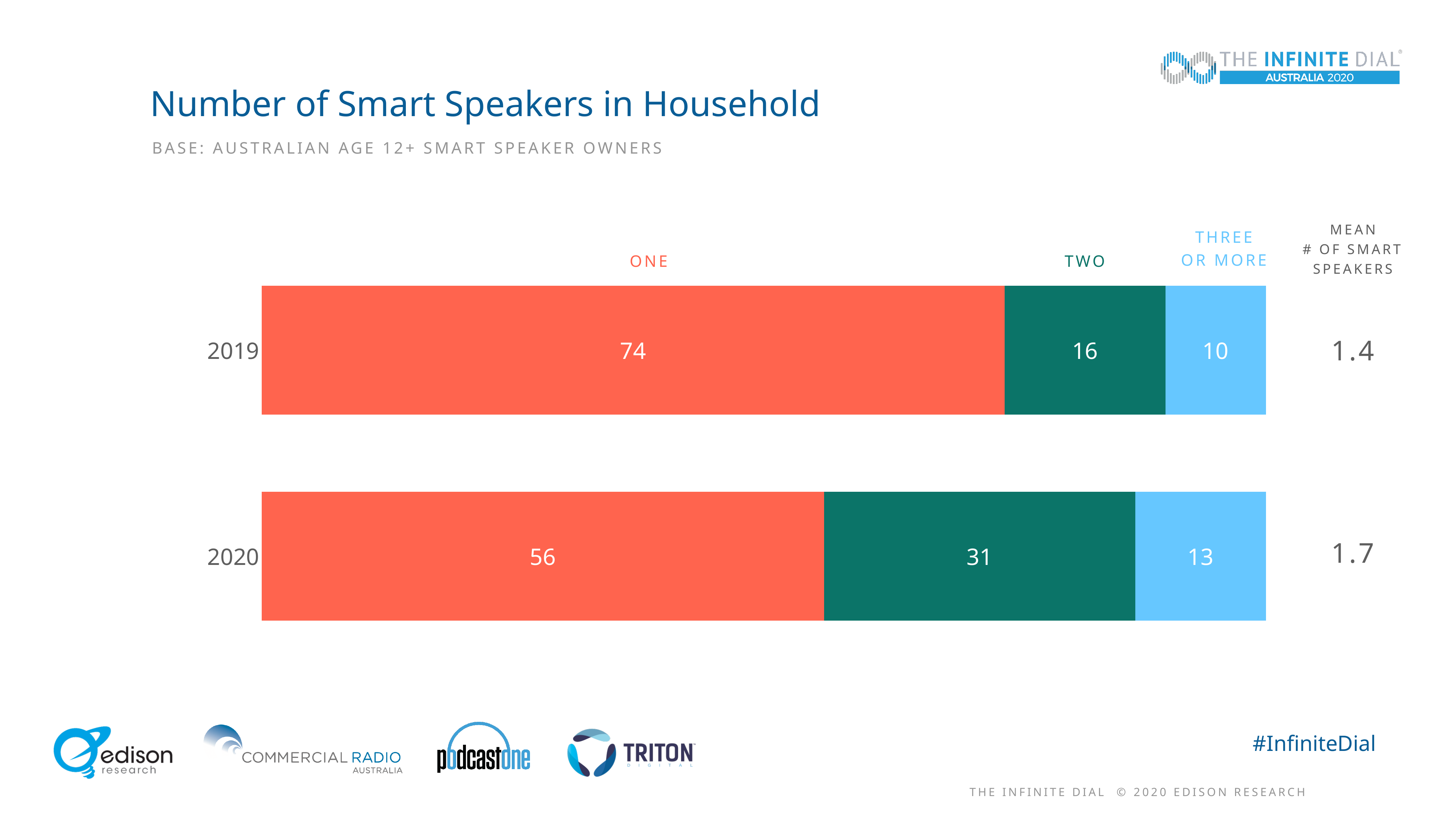
Which is larger: the "Two" value in 2019 or the "Two" value in 2020? 2020 How many series (segment categories) does the chart show? 3 What is the mean number of smart speakers shown for 2020? 1.7 What is the value for "Three or more" smart speakers in 2019? 10 What is the value for "Two" smart speakers in 2020? 31 What is the difference between the "One" values for 2019 and 2020? 18 Which category has the lowest value in the 2019 bar? Three or more Which category has the highest value in the 2020 bar? One What kind of chart is shown on the slide? Stacked bar chart What is the value for "One" smart speaker in 2019? 74 How many years (bars) are shown in the chart? 2 What is the total of the 2020 stacked bar? 100